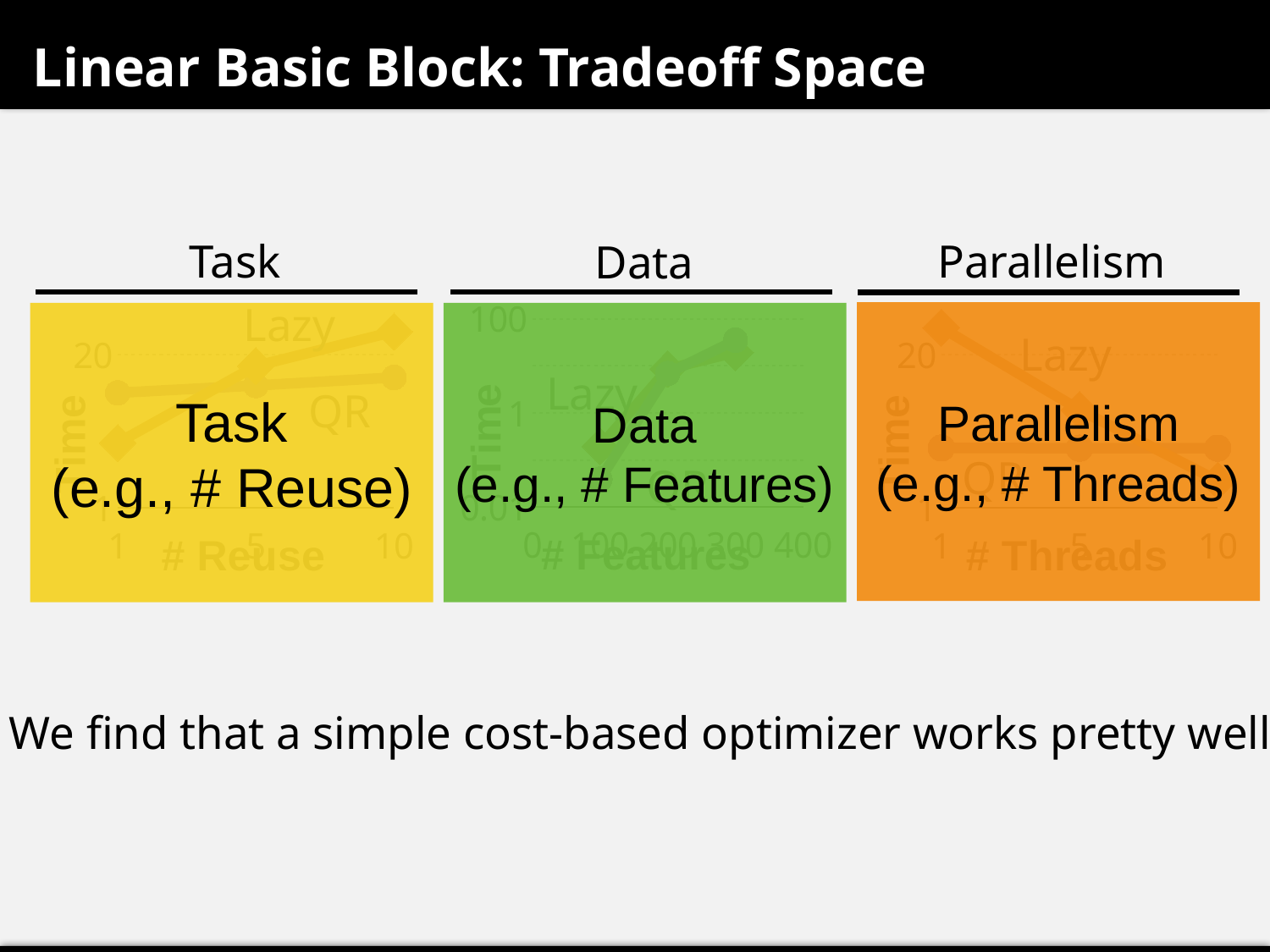
What kind of chart is the Task chart on the left? line chart What kind of chart is the Parallelism chart on the right? line chart In the Task chart on the left, what is the x-axis label? # Reuse How many charts are shown on the slide? 3 In the Parallelism chart on the right, does the Lazy line rise or fall as # Threads increases? fall In the Task chart on the left, does the Lazy line rise or fall as # Reuse increases? rise In the Data chart in the middle, what is the x-axis label? # Features